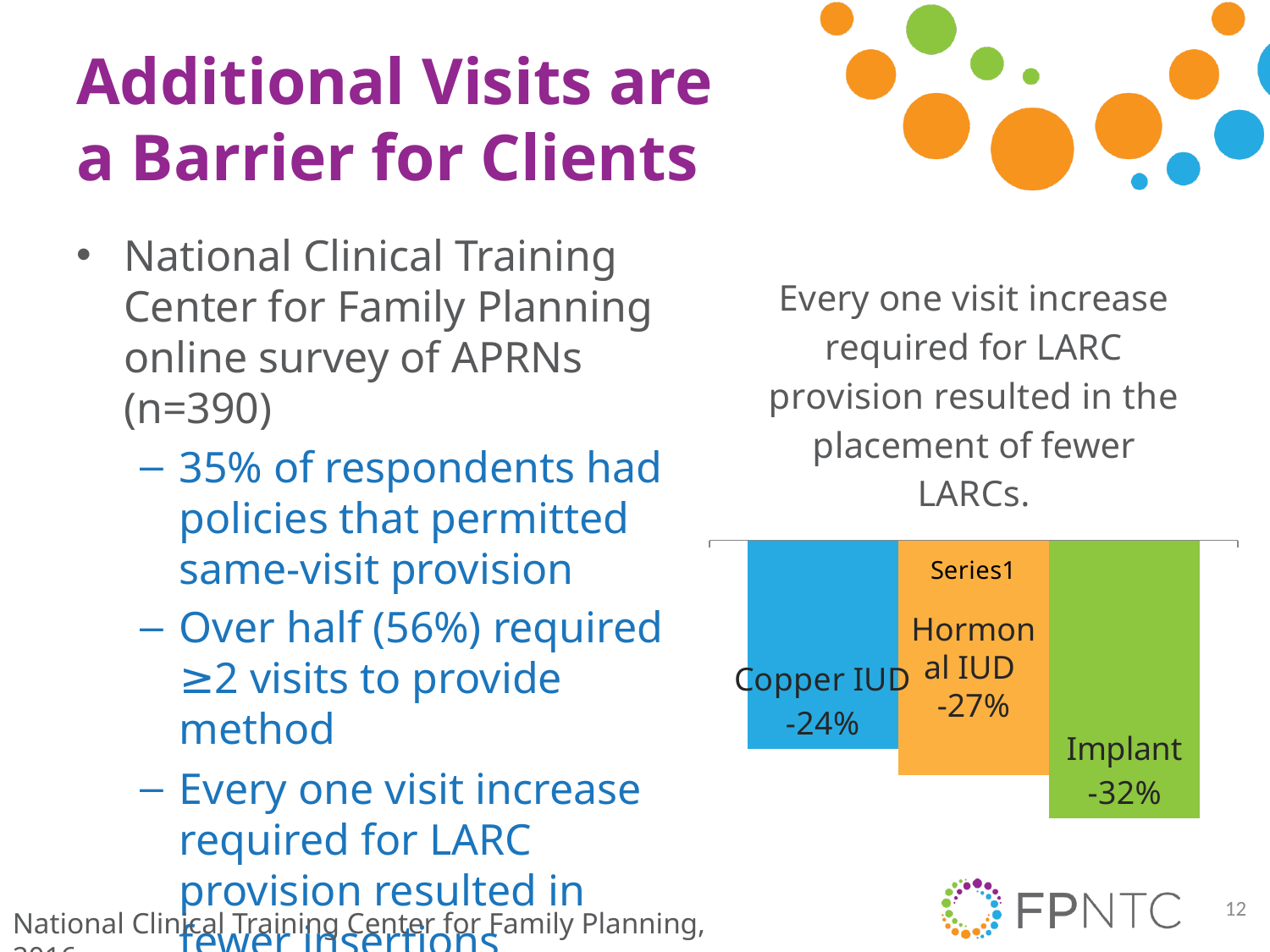
What is the value shown for Copper IUD in the chart? -24% Do the values in the chart rise or fall from left to right? Fall What is the value shown for Implant in the chart? -32% How many categories are plotted in the chart? 3 What kind of chart is shown on the slide? Bar chart Which category in the chart shows the smallest decrease? Copper IUD What colour is the Implant bar in the chart? Green Which shows a larger decrease, Hormonal IUD or Implant? Implant What is the difference in percentage points between the Hormonal IUD value and the Copper IUD value? 3 percentage points What is the value shown for Hormonal IUD in the chart? -27% Which category in the chart shows the largest decrease? Implant What is the difference in percentage points between the Implant value and the Copper IUD value? 8 percentage points